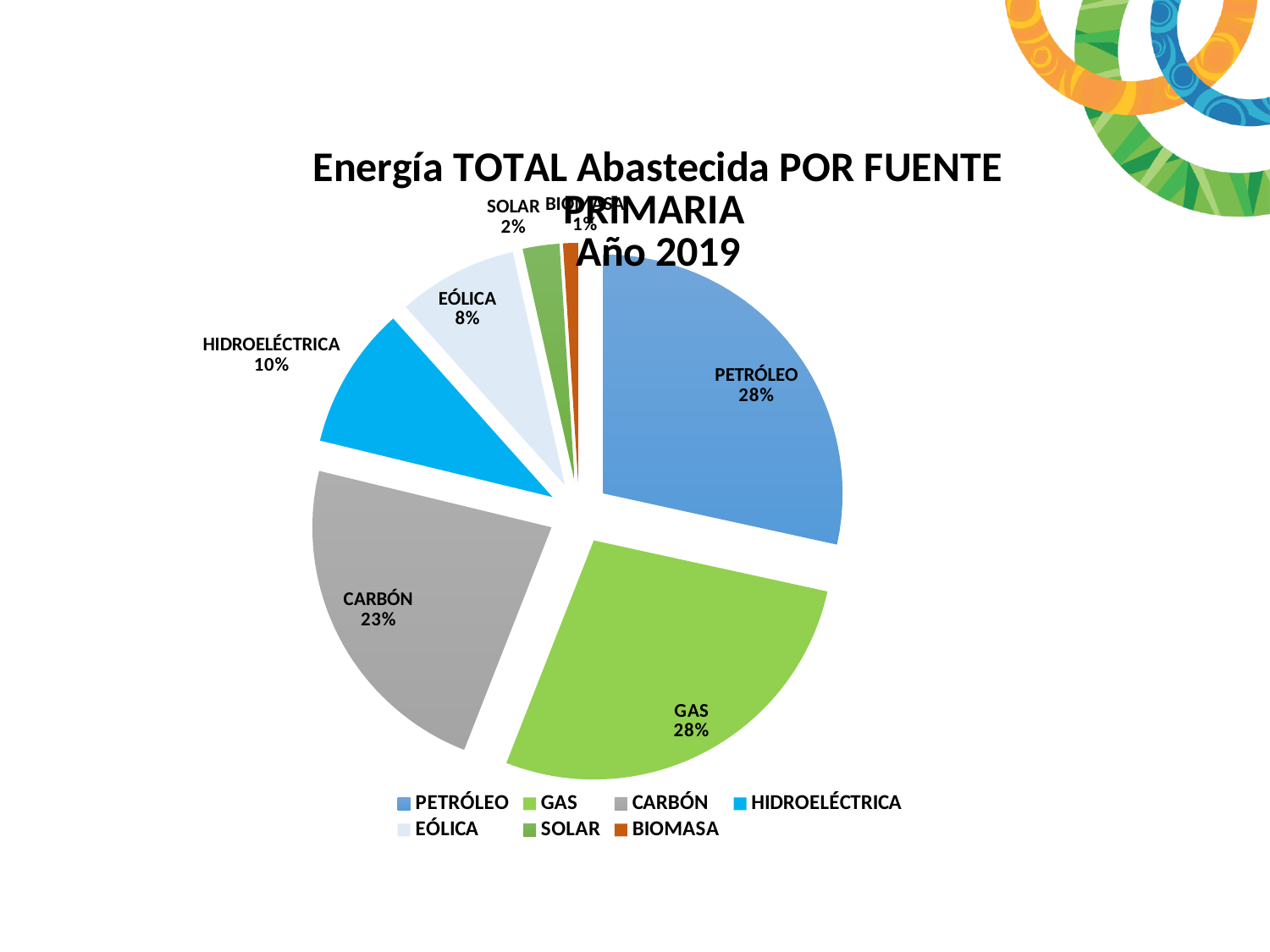
What type of chart is shown on the slide? pie chart How many entries does the legend list? 7 What year does the chart title refer to? 2019 How many slices does the pie chart have? 7 Which has a larger share, CARBÓN or EÓLICA? CARBÓN What percentage is shown for HIDROELÉCTRICA? 10% What share of the pie does CARBÓN represent? 23% Which source has the smallest share of the pie? BIOMASA What is the difference in percentage points between CARBÓN and HIDROELÉCTRICA? 13 What percentage is shown for EÓLICA? 8% What percentage is shown for GAS? 28% What percentage is shown for SOLAR? 2%